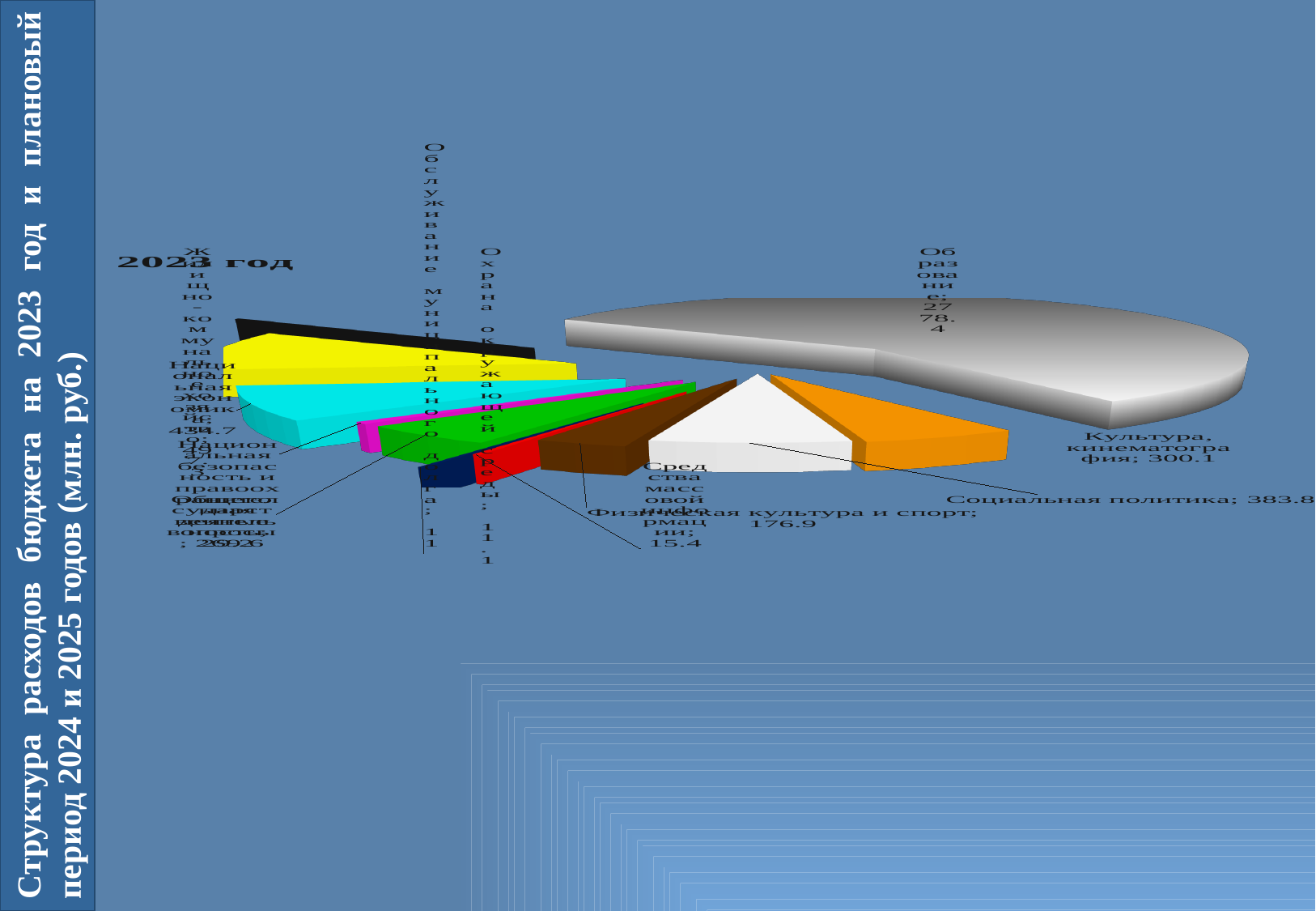
What is the difference between Социальная политика and Культура, кинематография? 83.7 What is the value for Средства массовой информации? 15.4 Which is larger, Социальная политика or Культура, кинематография? Социальная политика What is the value for Социальная политика? 383.8 What is the value for Физическая культура и спорт? 176.9 What kind of chart is shown on the slide? pie chart What colour is the slice for Образование? grey Which category has the largest slice of the pie? Образование What is the value for Культура, кинематография? 300.1 What is the difference between Социальная политика and Физическая культура и спорт? 206.9 In what units are the values given, according to the slide title? млн. руб. What is the value for Образование? 2778.4